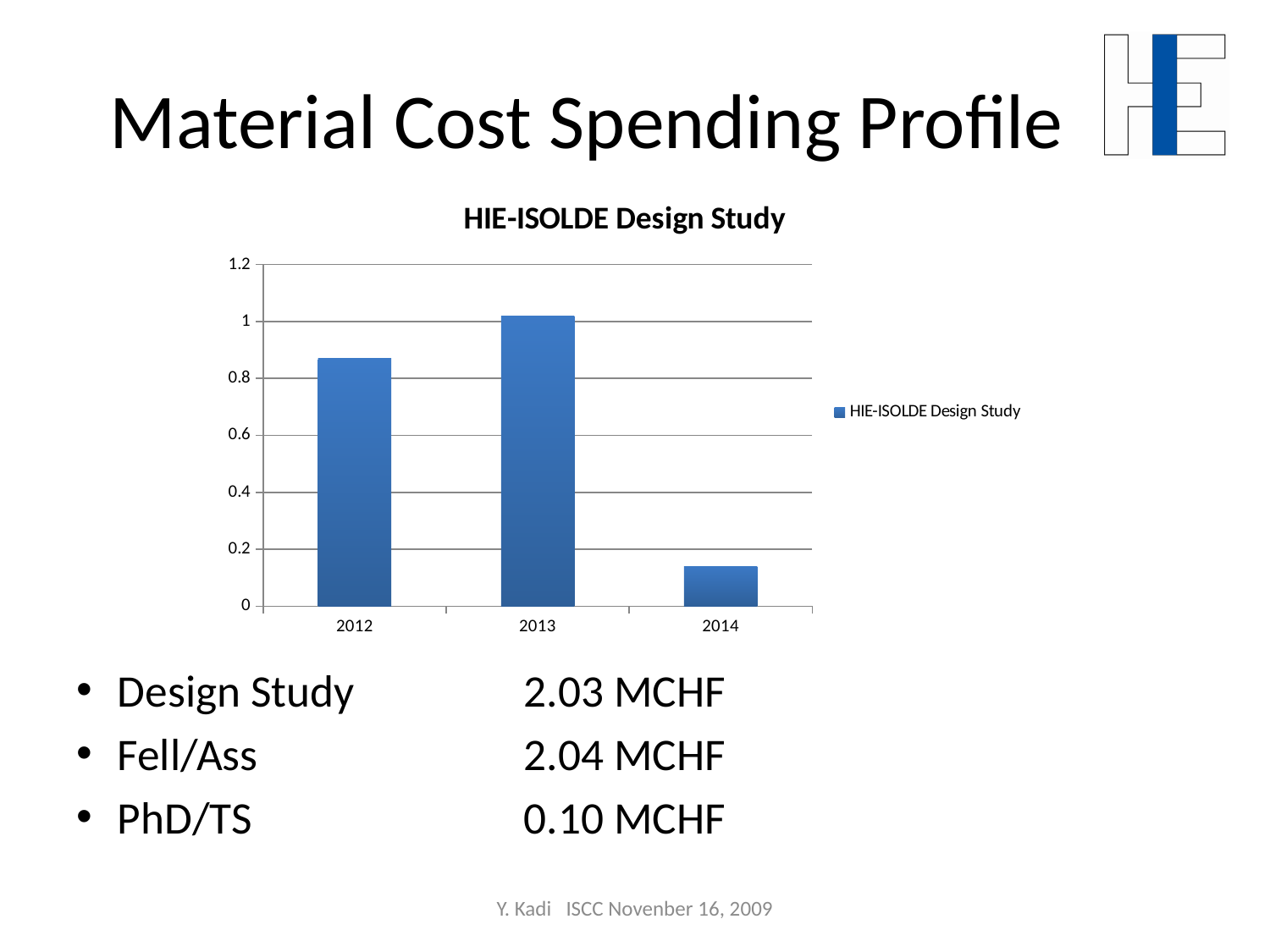
Does the value rise or fall from 2013 to 2014? fall What is the title of the chart? HIE-ISOLDE Design Study Is the value for 2013 greater or less than 1? greater Is the value for 2012 greater or less than 0.8? greater Which year has the highest bar in the chart? 2013 Which is larger, the value for 2012 or the value for 2014? 2012 How many categories are shown on the x axis of the chart? 3 How many series does the chart legend list? 1 Which year has the lowest bar in the chart? 2014 What kind of chart is shown on the slide? bar chart What is the name of the series shown in the chart legend? HIE-ISOLDE Design Study Is the value for 2014 greater or less than 0.2? less